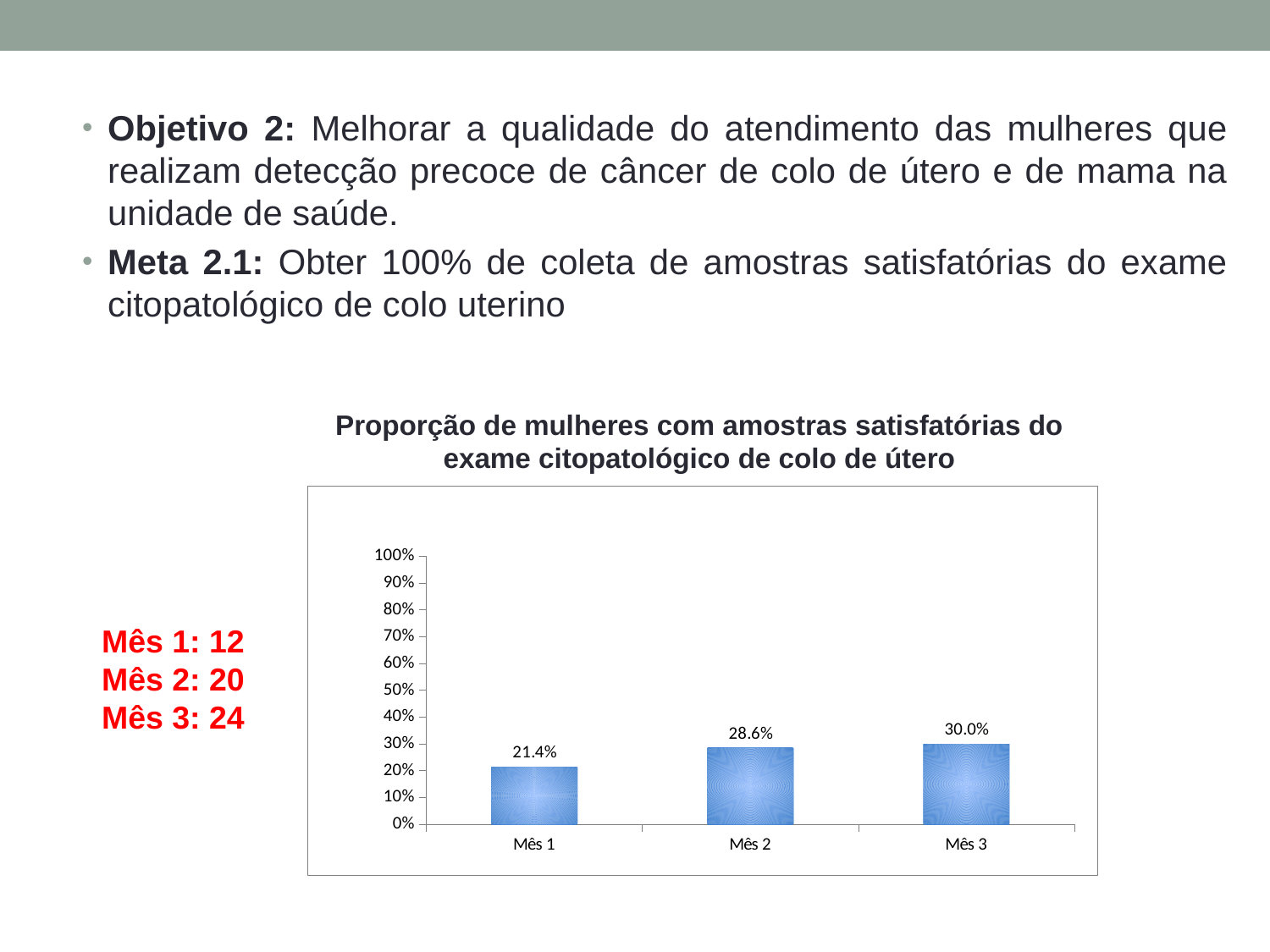
Do the values rise or fall from Mês 1 to Mês 3? rise What is the difference between the values for Mês 3 and Mês 1? 8.6% What is the value for Mês 3? 30.0% Which month has the lowest value? Mês 1 How many months are shown on the x axis? 3 Which is larger, the value for Mês 2 or the value for Mês 1? Mês 2 What is the title of the chart? Proporção de mulheres com amostras satisfatórias do exame citopatológico de colo de útero Which month has the highest value? Mês 3 What kind of chart is shown? bar chart What is the value for Mês 2? 28.6% What is the value for Mês 1? 21.4% Is the value for Mês 3 greater or less than 50%? less